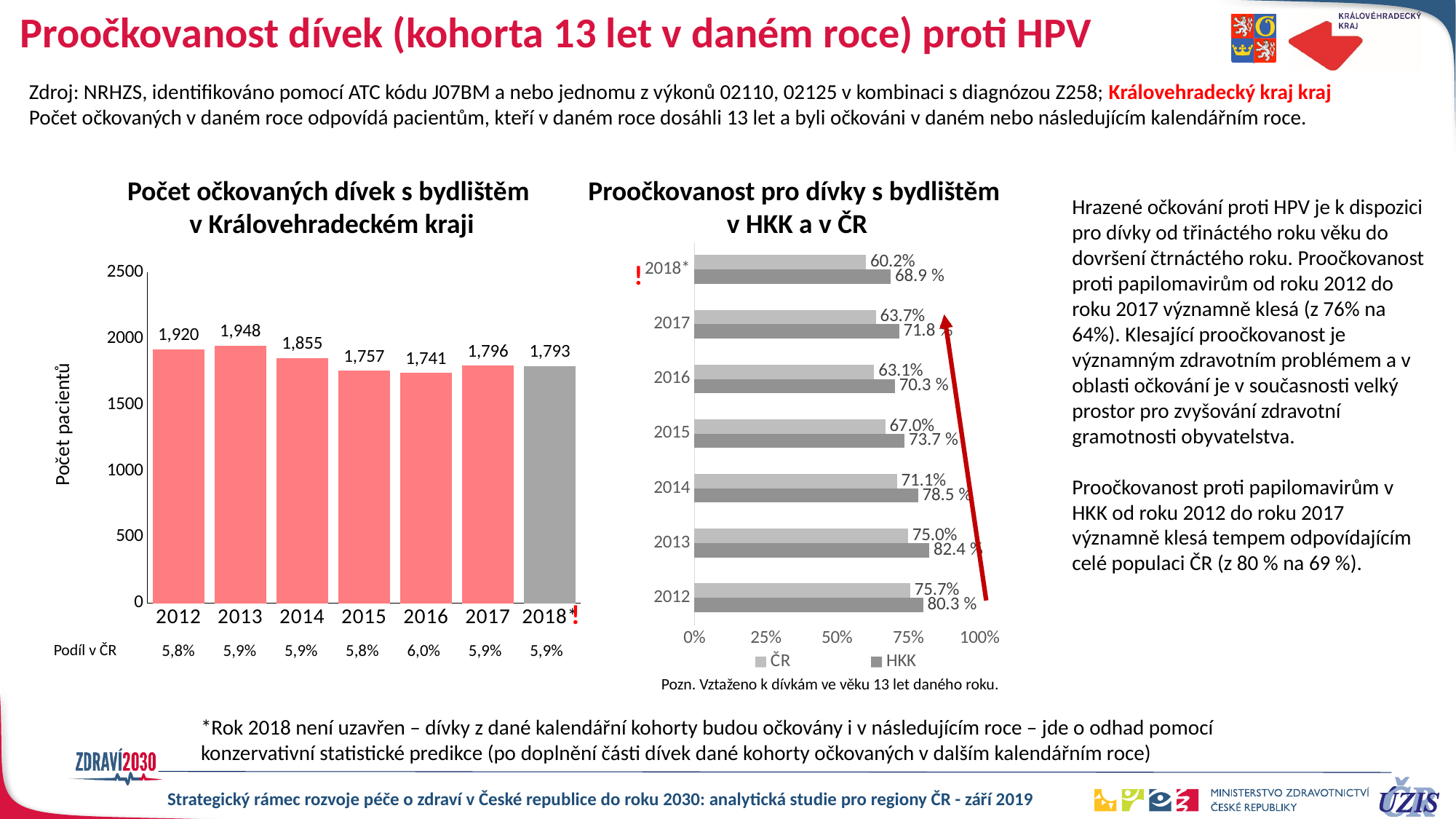
In the chart 'Proočkovanost pro dívky s bydlištěm v HKK a v ČR', which year has the lowest ČR value? 2018* In the chart 'Počet očkovaných dívek s bydlištěm v Královehradeckém kraji', how many years are shown on the x axis? 7 In the chart 'Počet očkovaných dívek s bydlištěm v Královehradeckém kraji', what is the difference between the values for 2012 and 2015? 163 In the chart 'Počet očkovaných dívek s bydlištěm v Královehradeckém kraji', what is the value for 2013? 1,948 In the chart 'Proočkovanost pro dívky s bydlištěm v HKK a v ČR', what is the ČR value for 2015? 67.0% In the chart 'Proočkovanost pro dívky s bydlištěm v HKK a v ČR', how many series does the legend list? 2 In the chart 'Počet očkovaných dívek s bydlištěm v Královehradeckém kraji', which year has the lowest value? 2016 In the chart 'Proočkovanost pro dívky s bydlištěm v HKK a v ČR', do the ČR values rise or fall from 2012 to 2018*? fall In the chart 'Počet očkovaných dívek s bydlištěm v Královehradeckém kraji', which year has the highest value? 2013 In the chart 'Proočkovanost pro dívky s bydlištěm v HKK a v ČR', is the HKK value for 2014 larger or the ČR value for 2014? HKK In the chart 'Proočkovanost pro dívky s bydlištěm v HKK a v ČR', what is the HKK value for 2018*? 68.9 % What kind of chart is 'Počet očkovaných dívek s bydlištěm v Královehradeckém kraji'? bar chart